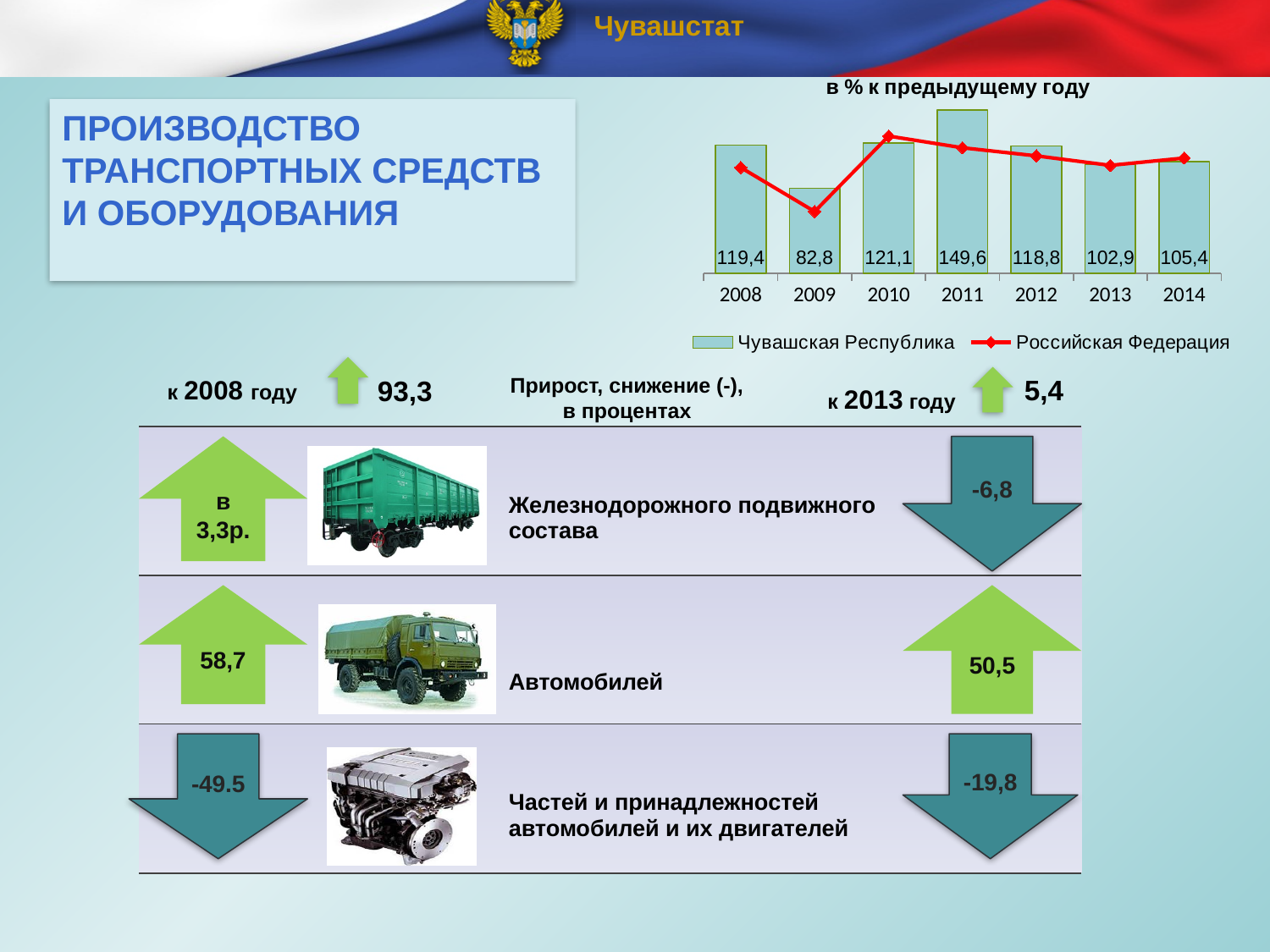
How many series does the chart legend list? 2 How many years are shown on the x axis of the chart? 7 Which year has the larger value for Чувашская Республика, 2010 or 2013? 2010 In which year is the value for Чувашская Республика lowest? 2009 What is the difference between the Чувашская Республика values for 2011 and 2009? 66,8 What is the value for Чувашская Республика in 2009? 82,8 In which year is the value for Чувашская Республика highest? 2011 What kind of chart is shown on the slide? Combined bar and line chart What is the value for Чувашская Республика in 2012? 118,8 What is the value for Чувашская Республика in 2014? 105,4 What is the value for Чувашская Республика in 2011? 149,6 Does the value for Чувашская Республика rise or fall from 2011 to 2013? Fall